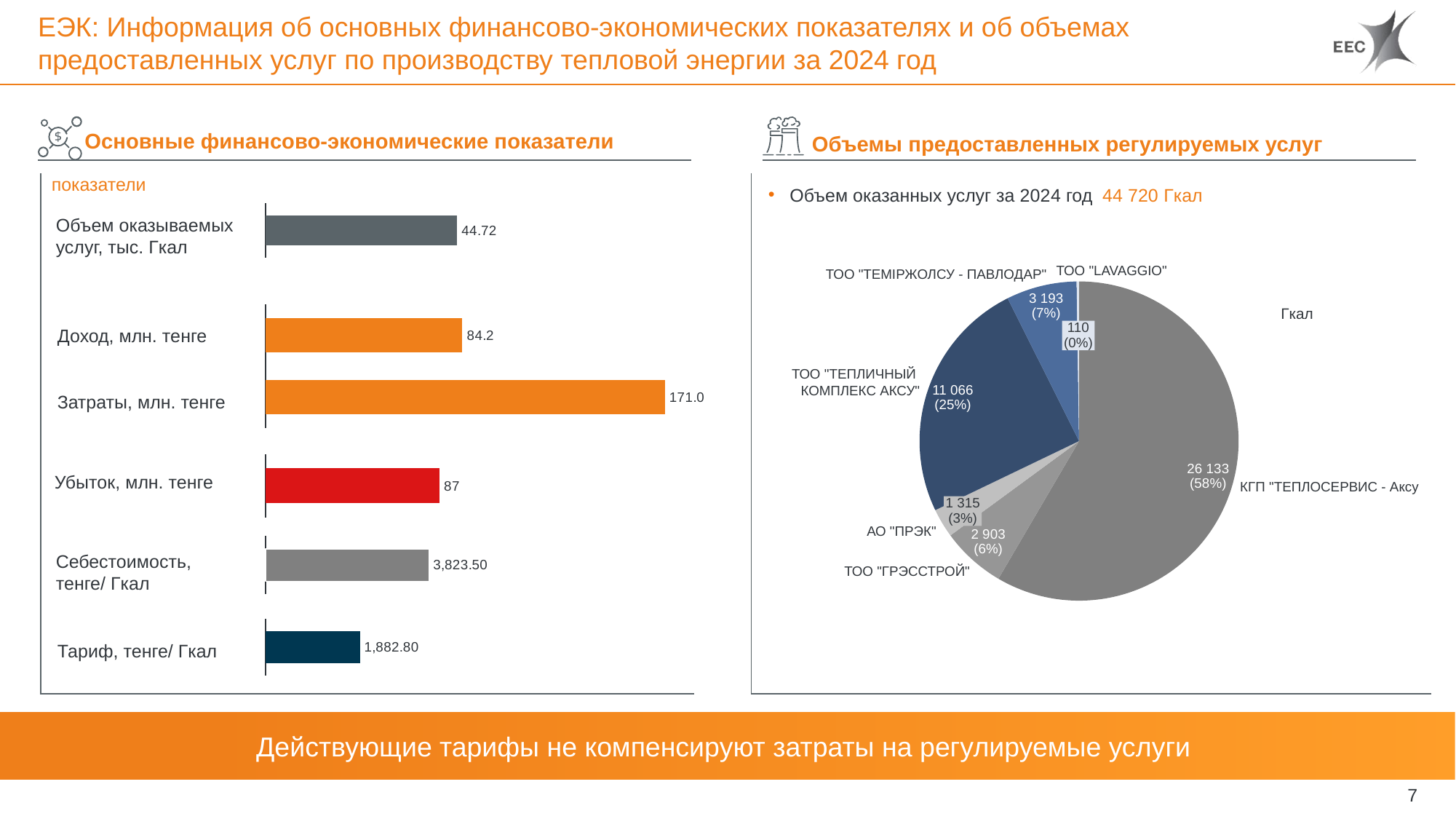
On the bar chart "Основные финансово-экономические показатели", what is the value for "Доход, млн. тенге"? 84.2 On the pie chart "Объемы предоставленных регулируемых услуг", what is the value for КГП "ТЕПЛОСЕРВИС - Аксу"? 26 133 On the pie chart "Объемы предоставленных регулируемых услуг", what share does ТОО "ТЕПЛИЧНЫЙ КОМПЛЕКС АКСУ" have? 25% On the bar chart "Основные финансово-экономические показатели", what is the value for "Себестоимость, тенге/ Гкал"? 3,823.50 On the pie chart "Объемы предоставленных регулируемых услуг", which company has the smallest slice? ТОО "LAVAGGIO" On the bar chart "Основные финансово-экономические показатели", what is the value for "Тариф, тенге/ Гкал"? 1,882.80 On the pie chart "Объемы предоставленных регулируемых услуг", how many slices are there? 6 On the pie chart "Объемы предоставленных регулируемых услуг", which is larger: ТОО "ГРЭССТРОЙ" or АО "ПРЭК"? ТОО "ГРЭССТРОЙ" On the bar chart "Основные финансово-экономические показатели", how many categories are plotted? 6 On the bar chart "Основные финансово-экономические показатели", what is the difference between "Затраты, млн. тенге" and "Доход, млн. тенге"? 86.8 What kind of chart is shown under "Основные финансово-экономические показатели"? Bar chart On the bar chart "Основные финансово-экономические показатели", what is the value for "Затраты, млн. тенге"? 171.0